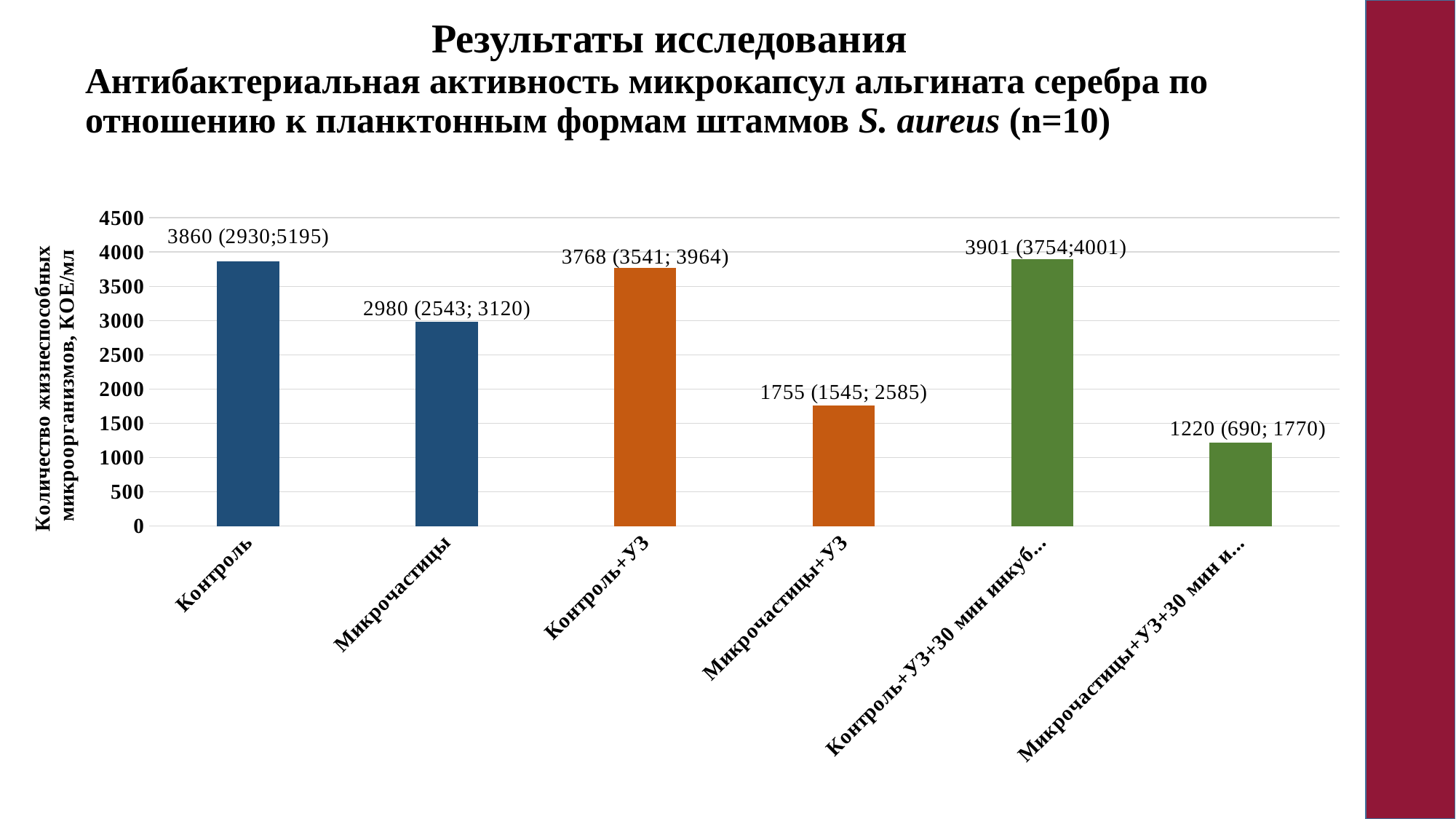
What is the value shown for Контроль? 3860 What type of chart is shown on the slide? bar chart How many bars (categories) are plotted in the chart? 6 Which category has the lowest value? the sixth (rightmost) bar, Микрочастицы+УЗ+30 мин и... What is the value shown for Микрочастицы? 2980 What is the difference between the values for Контроль and Микрочастицы? 880 What is the value shown for Микрочастицы+УЗ? 1755 What is the value shown for Контроль+УЗ? 3768 Which is larger, the value for Контроль+УЗ or the value for Микрочастицы+УЗ? Контроль+УЗ What is the y-axis label of the chart? Количество жизнеспособных микроорганизмов, КОЕ/мл Which category has the highest value? the fifth bar, Контроль+УЗ+30 мин инкуб... What is the value shown for the sixth (rightmost) bar? 1220